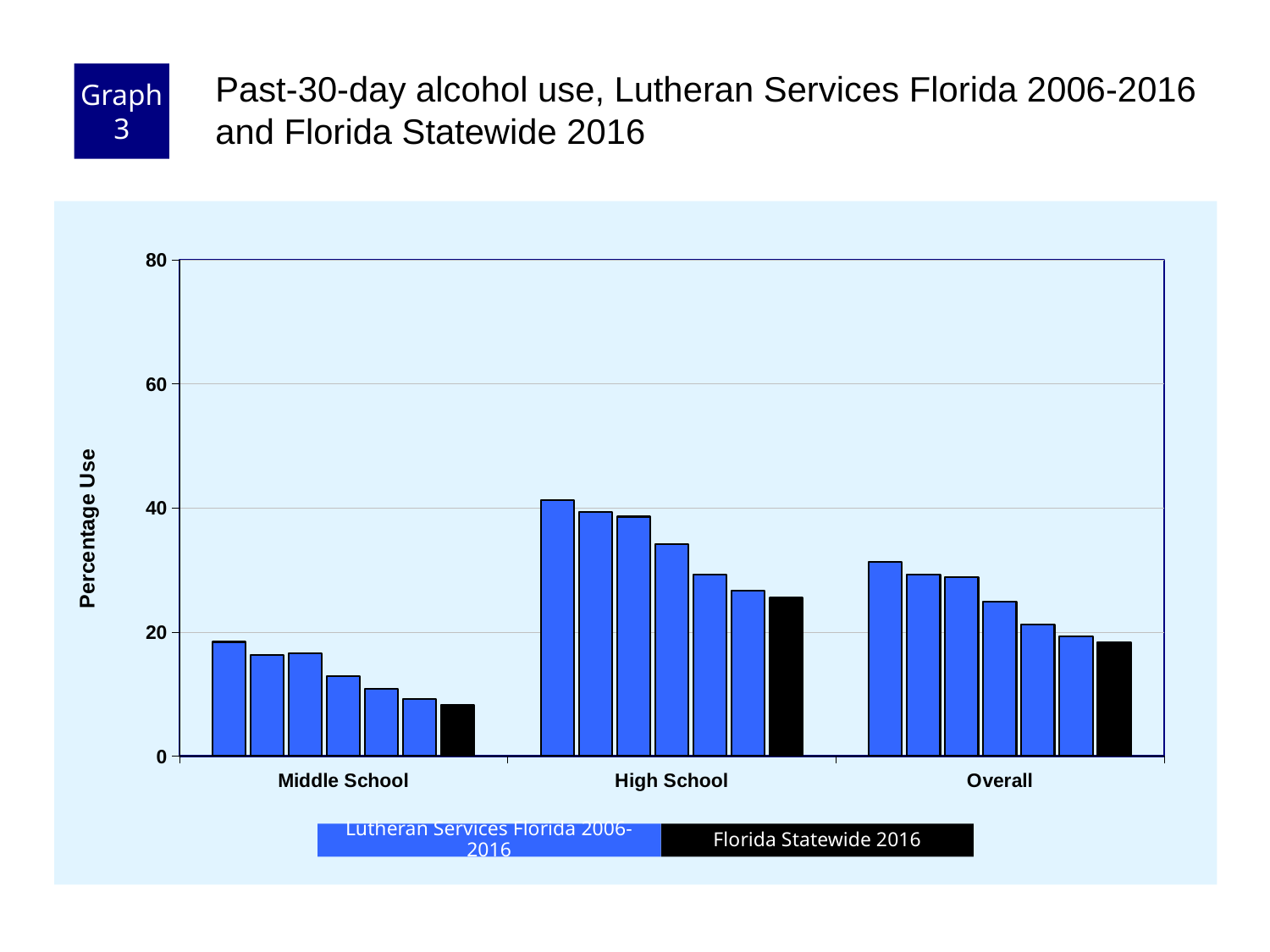
Is the Florida Statewide 2016 value for High School greater or less than 20? greater Is the Florida Statewide 2016 value for Middle School greater or less than 20? less Which category has the highest bars overall? High School Which category has the lowest bars overall? Middle School What kind of chart is shown on the slide? bar chart How many school-level categories are shown on the x axis? 3 Is the tallest Lutheran Services Florida bar for Overall greater or less than 40? less What is the title of the y axis? Percentage Use Within each category, do the Lutheran Services Florida 2006-2016 bars rise or fall from left to right? fall Which is larger: the Florida Statewide 2016 value for High School or for Middle School? High School How many series does the legend list? 2